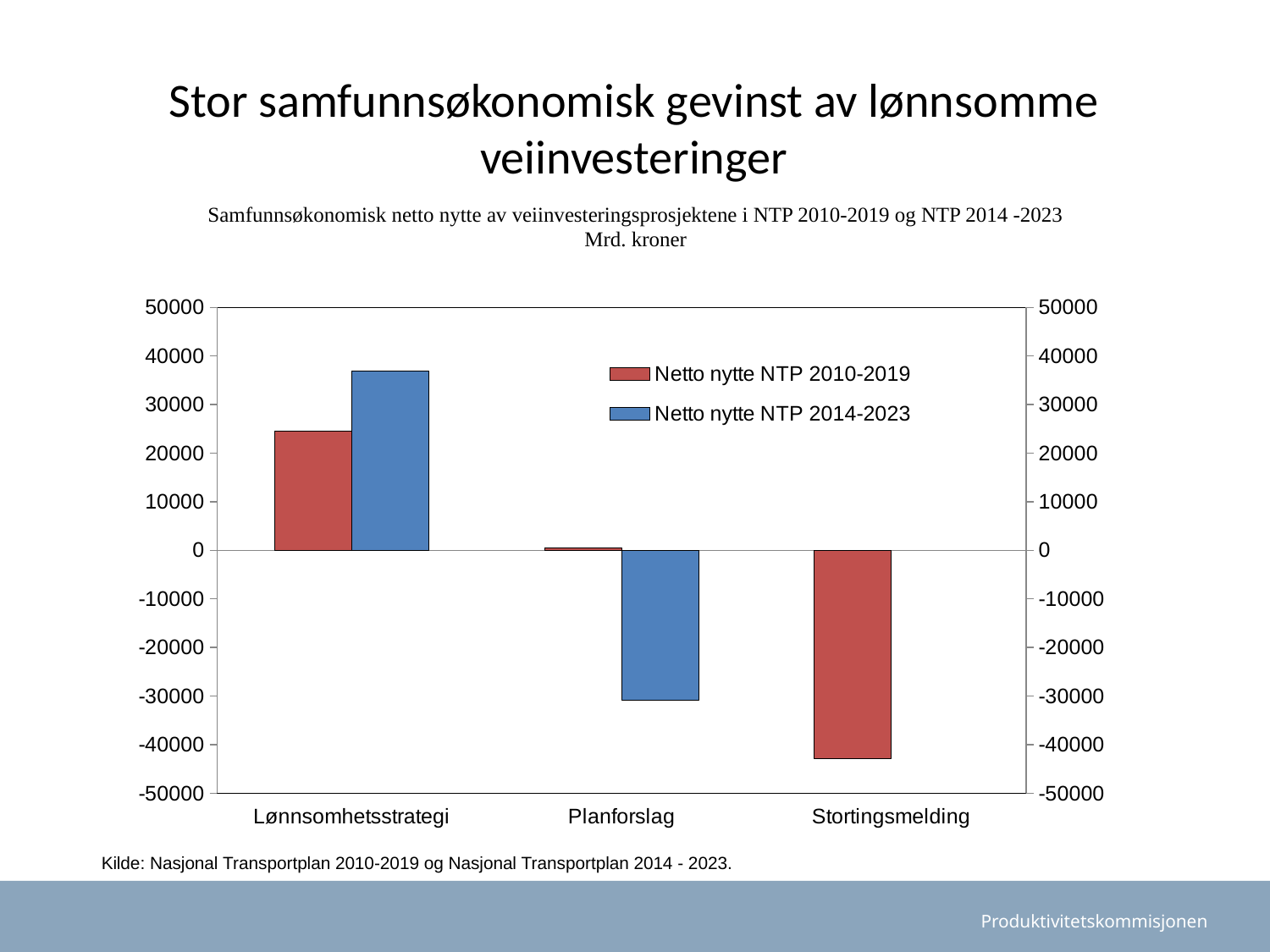
What kind of chart is shown on the slide? bar chart Is the value for Netto nytte NTP 2014-2023 in Planforslag greater or less than -20000? less Which category has the lowest value for Netto nytte NTP 2010-2019? Stortingsmelding Is the value for Netto nytte NTP 2010-2019 in Stortingsmelding greater or less than -40000? less How many series does the legend list? 2 Which category has the highest value for Netto nytte NTP 2014-2023? Lønnsomhetsstrategi Which colour represents Netto nytte NTP 2010-2019 in the legend? red Which category has the lowest value for Netto nytte NTP 2014-2023? Planforslag What unit is stated in the chart subtitle? Mrd. kroner For Lønnsomhetsstrategi, which series has the larger value: Netto nytte NTP 2010-2019 or Netto nytte NTP 2014-2023? Netto nytte NTP 2014-2023 Is the value for Netto nytte NTP 2014-2023 in Lønnsomhetsstrategi greater or less than 30000? greater How many categories are shown on the x axis? 3